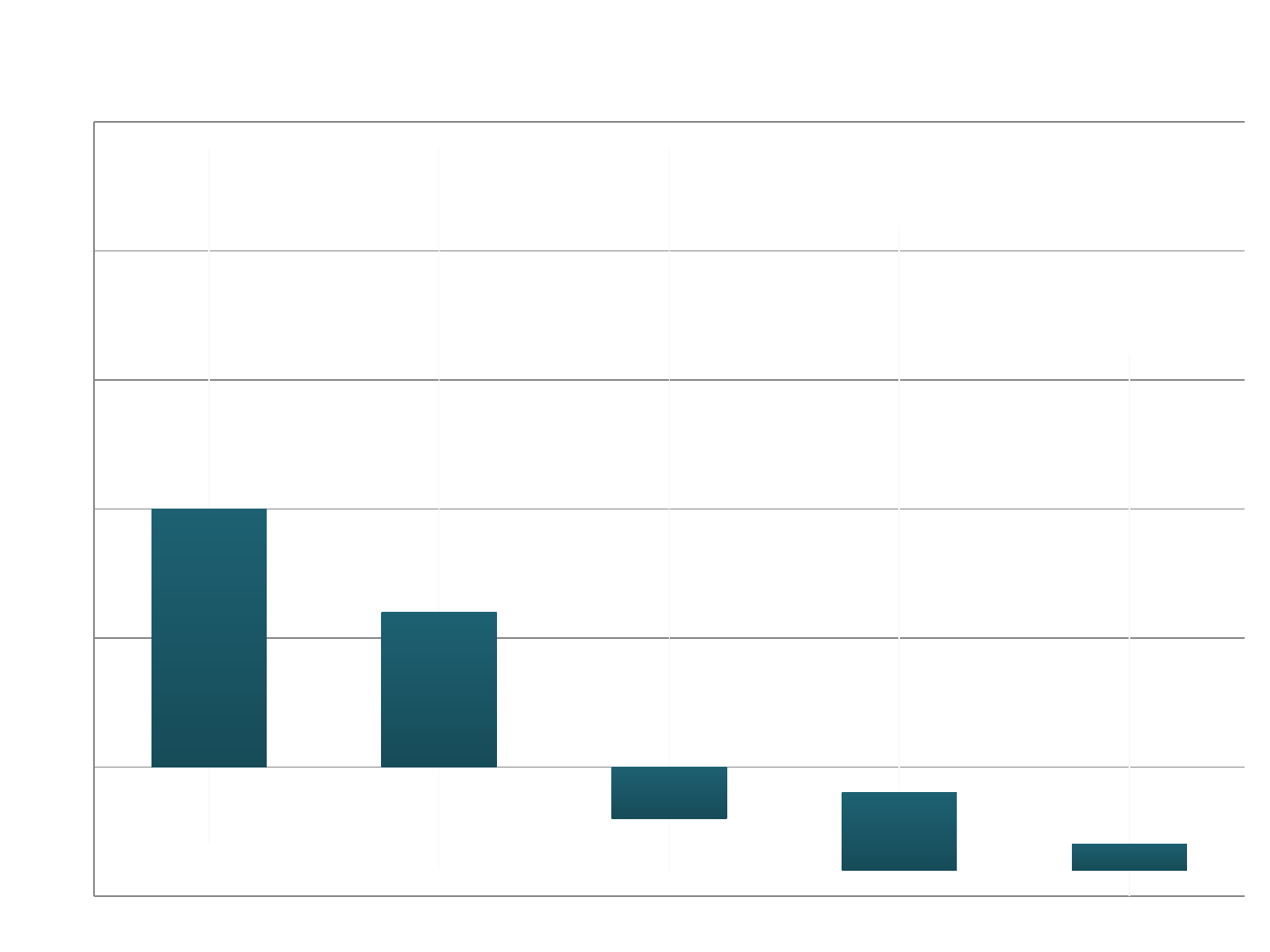
Do the first two bars from the left rise or fall from left to right? fall Which bar, by position from the left, is the lowest in the chart? the fifth bar How many bars are plotted in the chart? 5 What colour are the bars in the chart? dark teal Does the chart display a legend? No What kind of chart is shown on the slide? bar chart Which is larger, the fifth bar or the fourth bar from the left? the fourth bar Which is larger, the first bar or the second bar from the left? the first bar Which bar, by position from the left, is the highest in the chart? the first (leftmost) bar